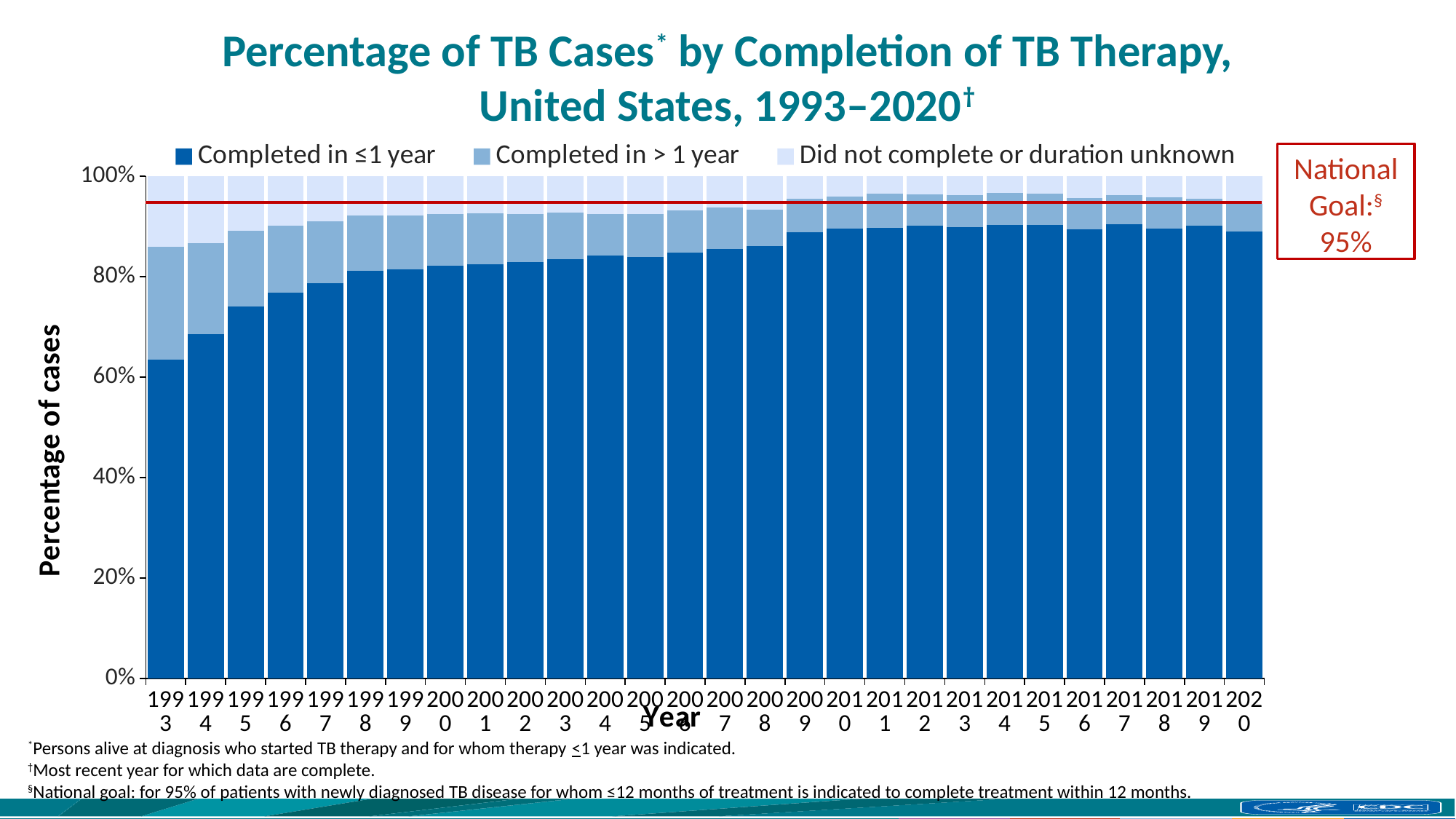
Is the value for 'Completed in ≤1 year' in 1993 greater or less than 60%? greater Does the 'Completed in ≤1 year' series generally rise or fall from 1993 to 2020? Rise What is the title of the y axis? Percentage of cases Which is larger, the 'Completed in ≤1 year' value for 1995 or for 1996? 1996 Is the value for 'Completed in ≤1 year' in 2020 greater or less than 80%? greater What kind of chart is shown on the slide? Stacked bar chart Which is larger, the 'Completed in ≤1 year' value for 1993 or for 2020? 2020 How many series does the legend list? 3 Is the value for 'Completed in ≤1 year' in 1993 greater or less than 80%? less What is the National Goal percentage marked by the red line on the chart? 95% How many years (bars) are plotted on the x axis? 28 Which year has the lowest value for 'Completed in ≤1 year'? 1993